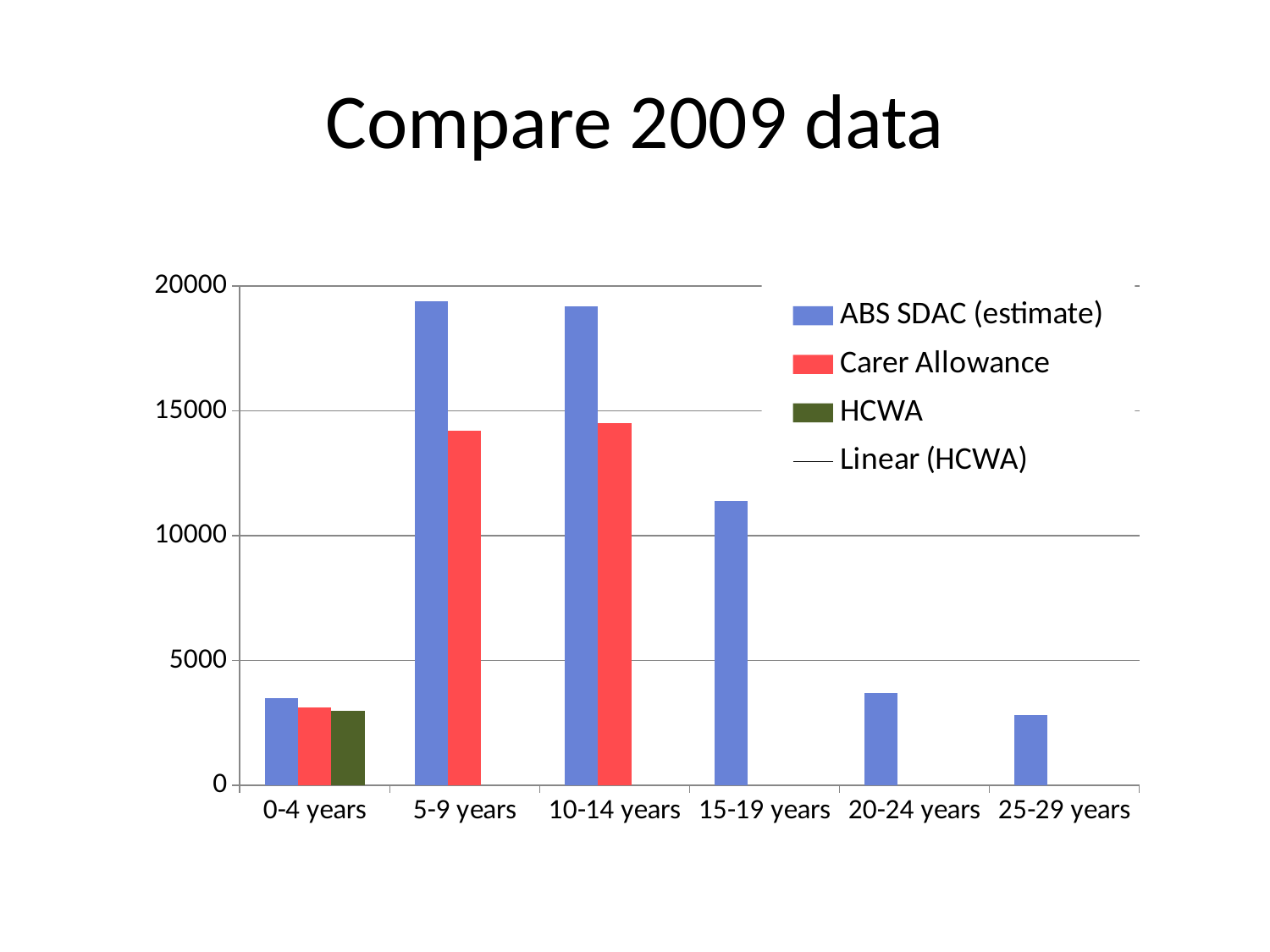
What is the title of the chart? Compare 2009 data Is the ABS SDAC (estimate) value for 0-4 years greater or less than 5000? less Is the ABS SDAC (estimate) value for 15-19 years greater or less than 10000? greater Is the HCWA value for 0-4 years greater or less than 5000? less Which age group has the lowest Carer Allowance value? 0-4 years Do the ABS SDAC (estimate) values rise or fall from 15-19 years to 25-29 years? fall Which age group has the lowest ABS SDAC (estimate) value? 25-29 years For 5-9 years, which is larger: ABS SDAC (estimate) or Carer Allowance? ABS SDAC (estimate) What kind of chart is shown on the slide? bar chart How many series does the legend list? 4 How many age-group categories are shown on the x axis? 6